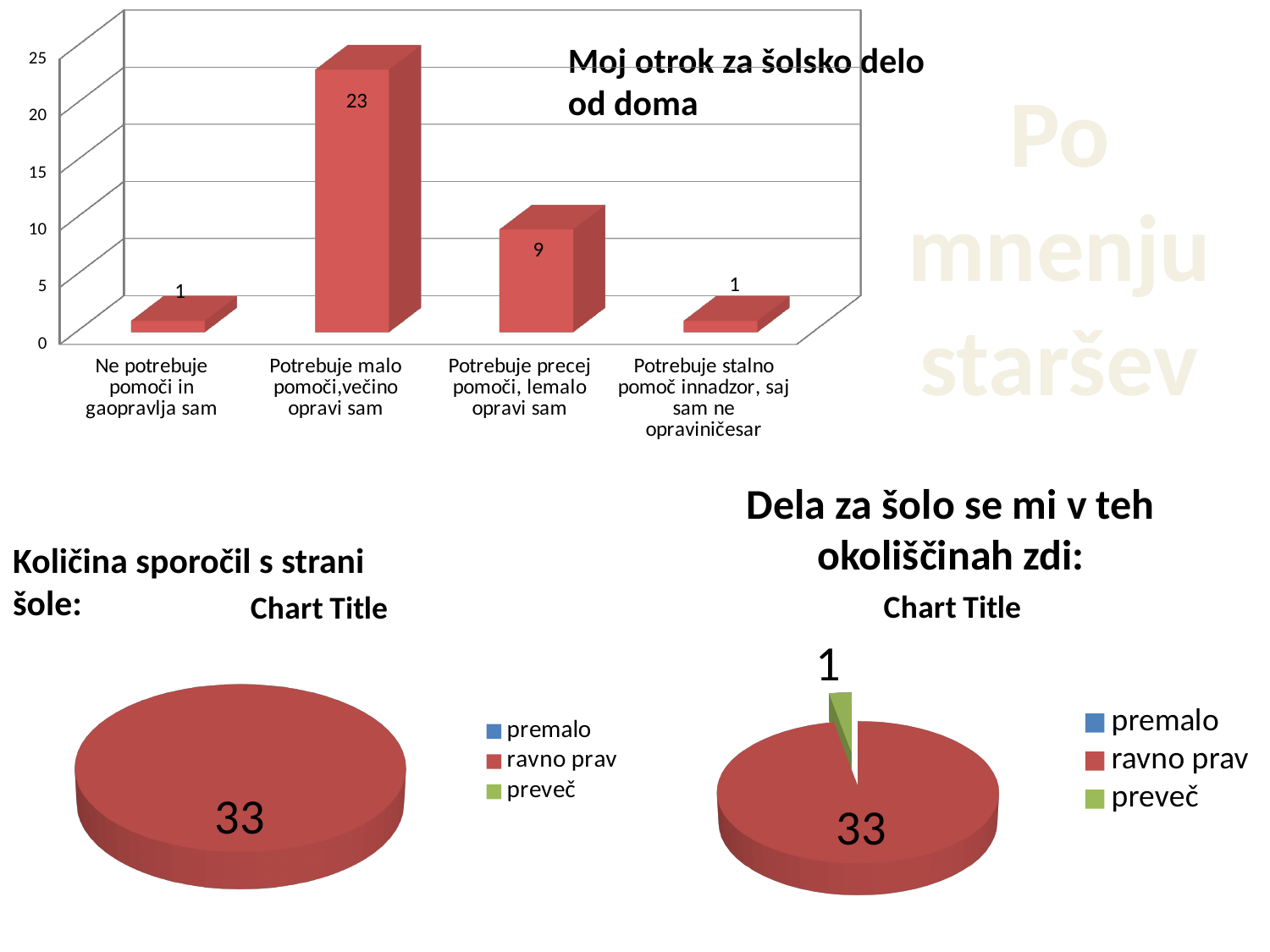
In the bar chart 'Moj otrok za šolsko delo od doma', how many categories are shown? 4 In the bar chart 'Moj otrok za šolsko delo od doma', what is the value for 'Potrebuje malo pomoči, večino opravi sam'? 23 In the bar chart 'Moj otrok za šolsko delo od doma', what is the value for 'Potrebuje precej pomoči, le malo opravi sam'? 9 In the bar chart 'Moj otrok za šolsko delo od doma', which category has the highest value? Potrebuje malo pomoči, večino opravi sam In the bottom-left pie chart (Količina sporočil s strani šole), what value is shown for 'ravno prav'? 33 In the bottom-right pie chart (Dela za šolo se mi v teh okoliščinah zdi), which slice is larger, 'ravno prav' or 'preveč'? ravno prav How many entries does the legend of the bottom-right pie chart list? 3 In the bar chart 'Moj otrok za šolsko delo od doma', is the value for 'Potrebuje malo pomoči, večino opravi sam' greater or less than 20? greater What kind of chart is the top chart 'Moj otrok za šolsko delo od doma'? bar chart In the bar chart 'Moj otrok za šolsko delo od doma', what is the difference between the values for 'Potrebuje malo pomoči, večino opravi sam' and 'Potrebuje precej pomoči, le malo opravi sam'? 14 What kind of chart is the bottom-left chart (Količina sporočil s strani šole)? pie chart In the bottom-right pie chart (Dela za šolo se mi v teh okoliščinah zdi), what value is shown for 'preveč'? 1